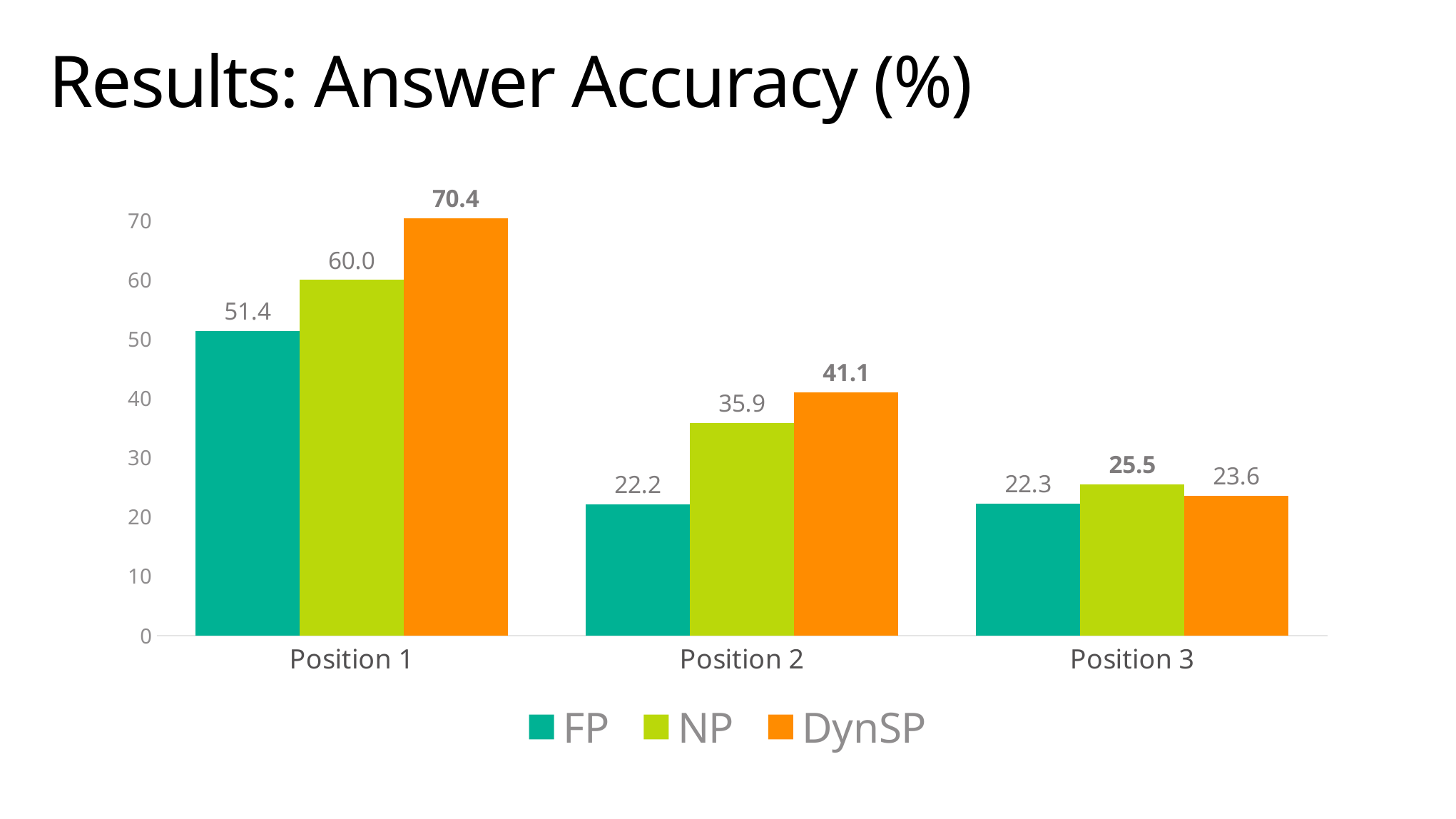
What is the difference between DynSP and FP at Position 1? 19.0 What is the value for DynSP at Position 1? 70.4 What is the difference between DynSP and NP at Position 2? 5.2 What kind of chart is shown on the slide? Bar chart Do the DynSP values rise or fall from Position 1 to Position 3? Fall Which series has the lowest value at Position 2? FP How many series does the legend list? 3 Which is larger at Position 3, DynSP or FP? DynSP Which series has the highest value at Position 3? NP What is the value for FP at Position 3? 22.3 What is the value for NP at Position 2? 35.9 How many positions (categories) are shown on the x axis? 3